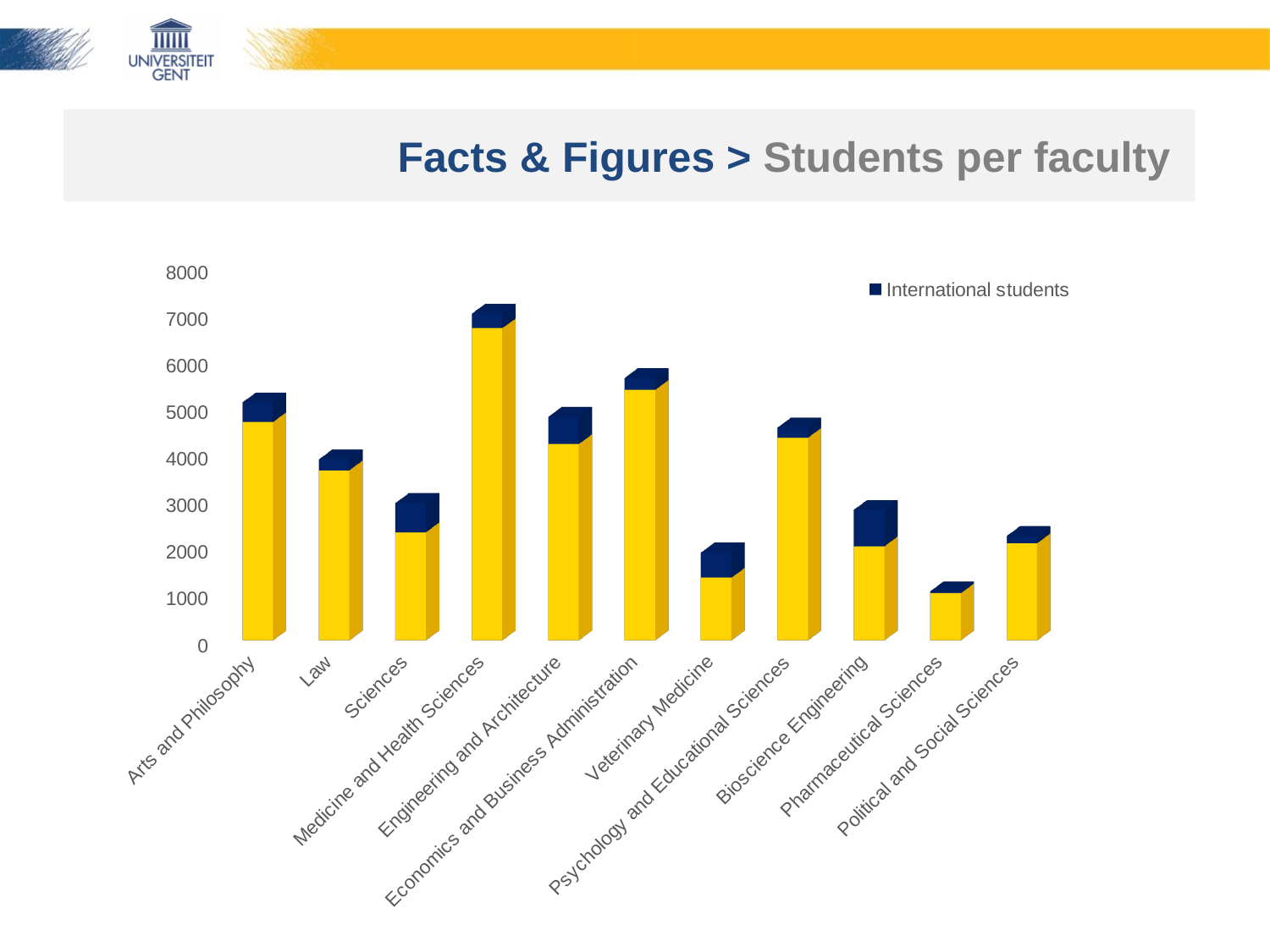
What series name is shown in the chart's legend? International students Is the total bar height for Medicine and Health Sciences greater or less than 6000? greater Which bar is taller: Arts and Philosophy or Law? Arts and Philosophy Which faculty has the shortest bar in the chart? Pharmaceutical Sciences Is the total bar height for Economics and Business Administration greater or less than 5000? greater How many faculties are shown on the x axis of the chart? 11 Is the total bar height for Veterinary Medicine greater or less than 3000? less How many series does the chart's legend list? 1 What kind of chart is shown on the slide? bar chart Which faculty has the tallest bar in the chart? Medicine and Health Sciences Which bar is taller: Veterinary Medicine or Pharmaceutical Sciences? Veterinary Medicine